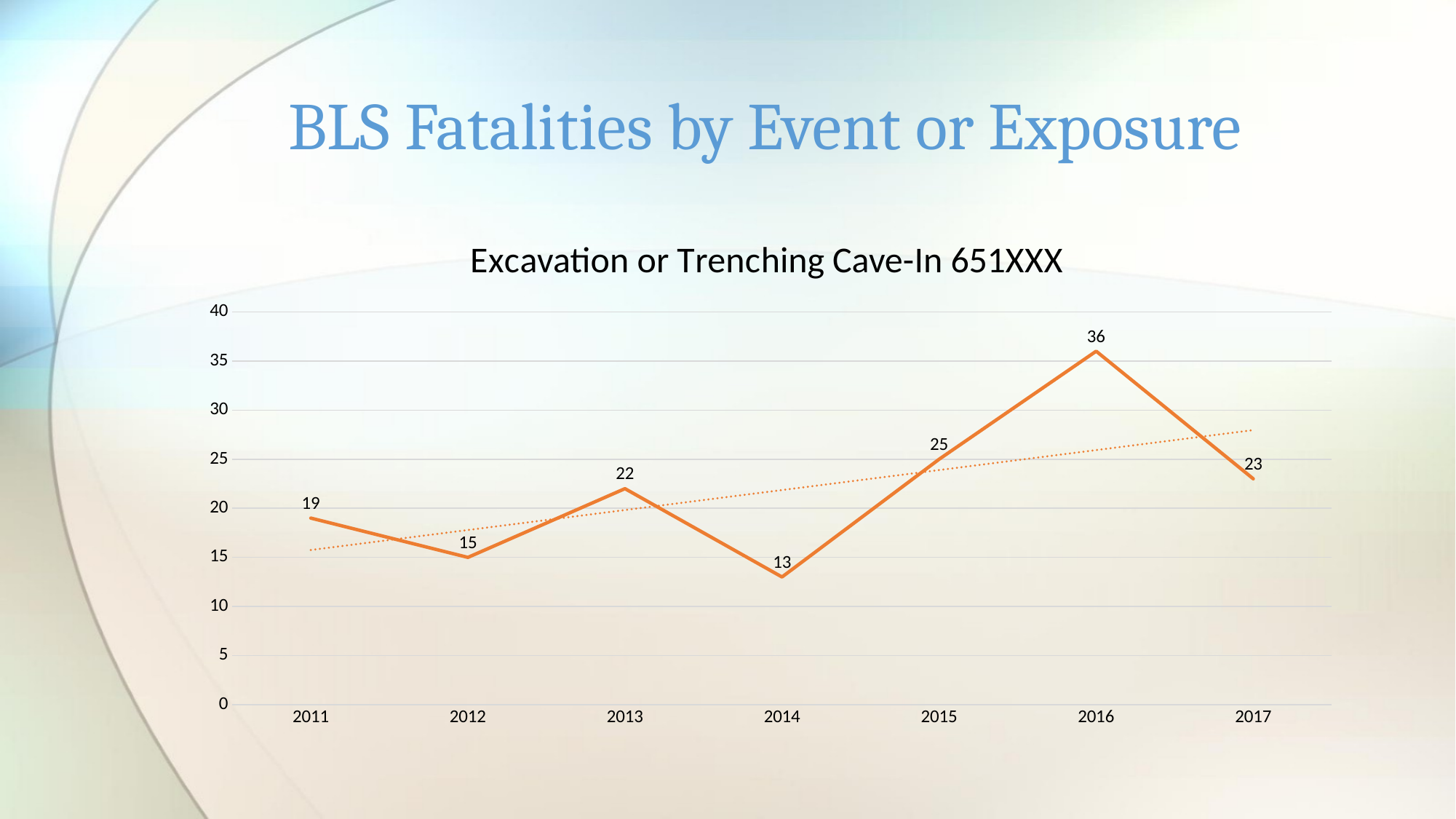
What is the value for 2016? 36 Which year has the lowest value? 2014 What is the value for 2011? 19 How many years are plotted on the x axis? 7 What is the value for 2014? 13 What is the title of the chart? Excavation or Trenching Cave-In 651XXX Which year has the highest value? 2016 What kind of chart is shown? Line chart What is the value for 2017? 23 Does the value rise or fall from 2014 to 2016? Rise Which is larger, the value for 2013 or the value for 2012? 2013 What is the difference between the values for 2016 and 2015? 11